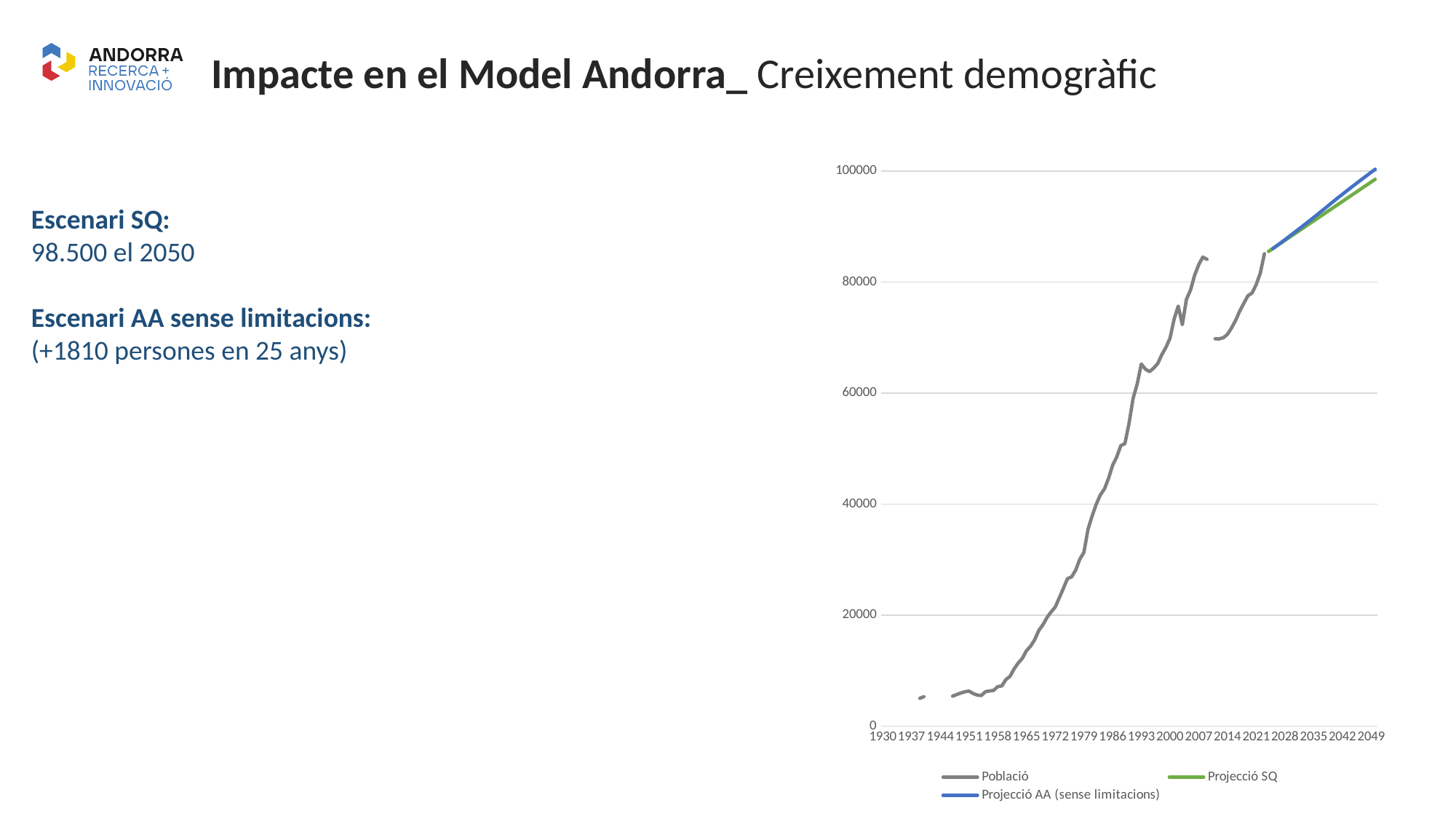
At 2049, which projection line is higher: Projecció SQ or Projecció AA (sense limitacions)? Projecció AA (sense limitacions) How many series does the chart legend list? 3 Is the Població value around 1972 greater or less than 40000? less What kind of chart is shown on the slide? line chart Is the Població value around 2014 greater or less than 60000? greater Is the Població value around 1930 greater or less than 20000? less What colour is the Projecció SQ line in the chart? green Does the Població line generally rise or fall from 1930 to 2021? rise What are the three series named in the chart legend? Població, Projecció SQ, Projecció AA (sense limitacions)